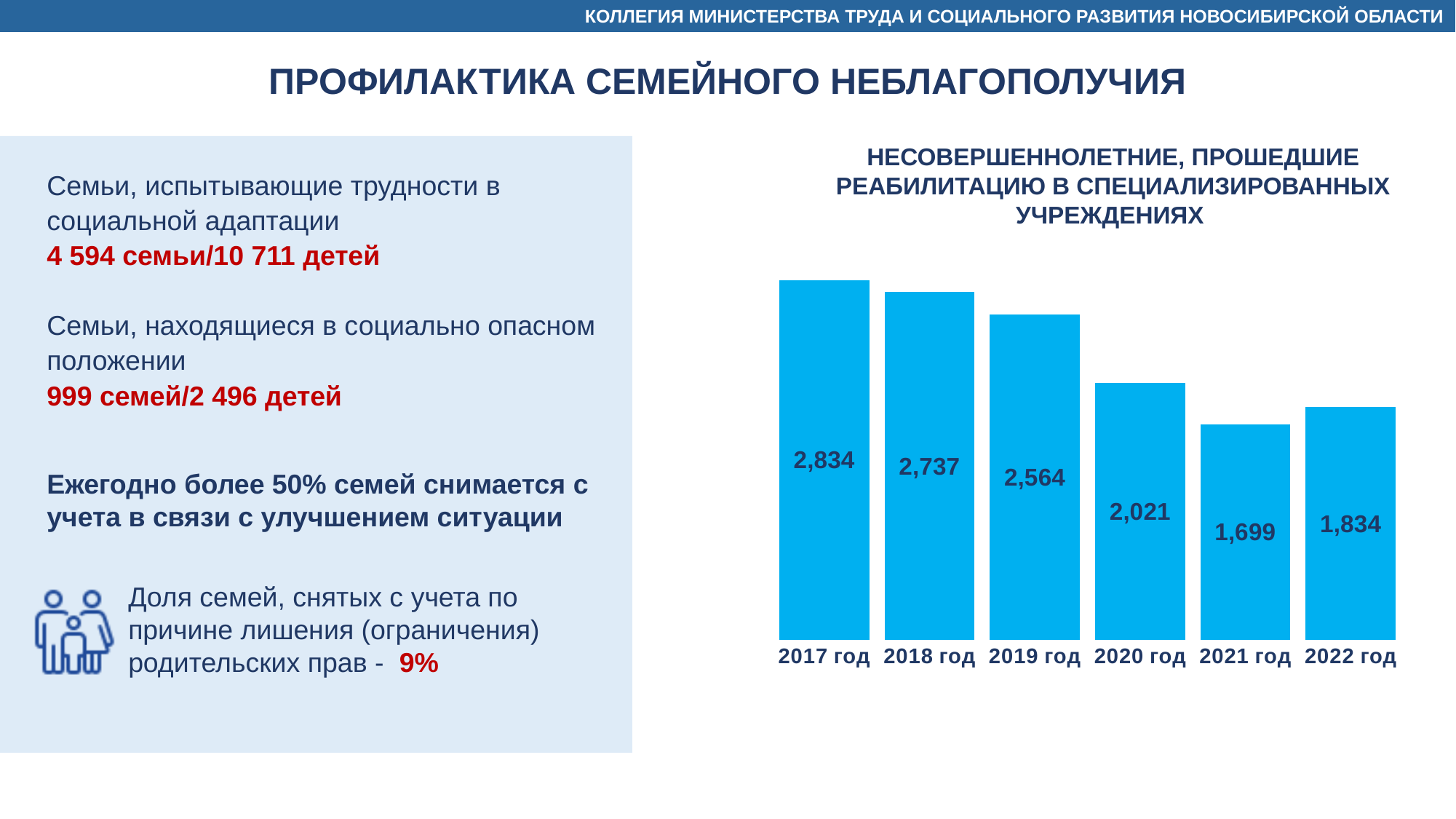
What is the difference between the values for 2022 год and 2021 год? 135 Which year has the highest value? 2017 год What is the value for 2017 год? 2,834 What is the title of the chart? НЕСОВЕРШЕННОЛЕТНИЕ, ПРОШЕДШИЕ РЕАБИЛИТАЦИЮ В СПЕЦИАЛИЗИРОВАННЫХ УЧРЕЖДЕНИЯХ What kind of chart is shown on the slide? bar chart How many years are shown on the chart? 6 Which year has the lowest value? 2021 год What is the difference between the values for 2017 год and 2018 год? 97 What is the value for 2020 год? 2,021 Which is larger, the value for 2019 год or the value for 2020 год? 2019 год Do the values rise or fall from 2017 год to 2021 год? fall What is the value for 2022 год? 1,834